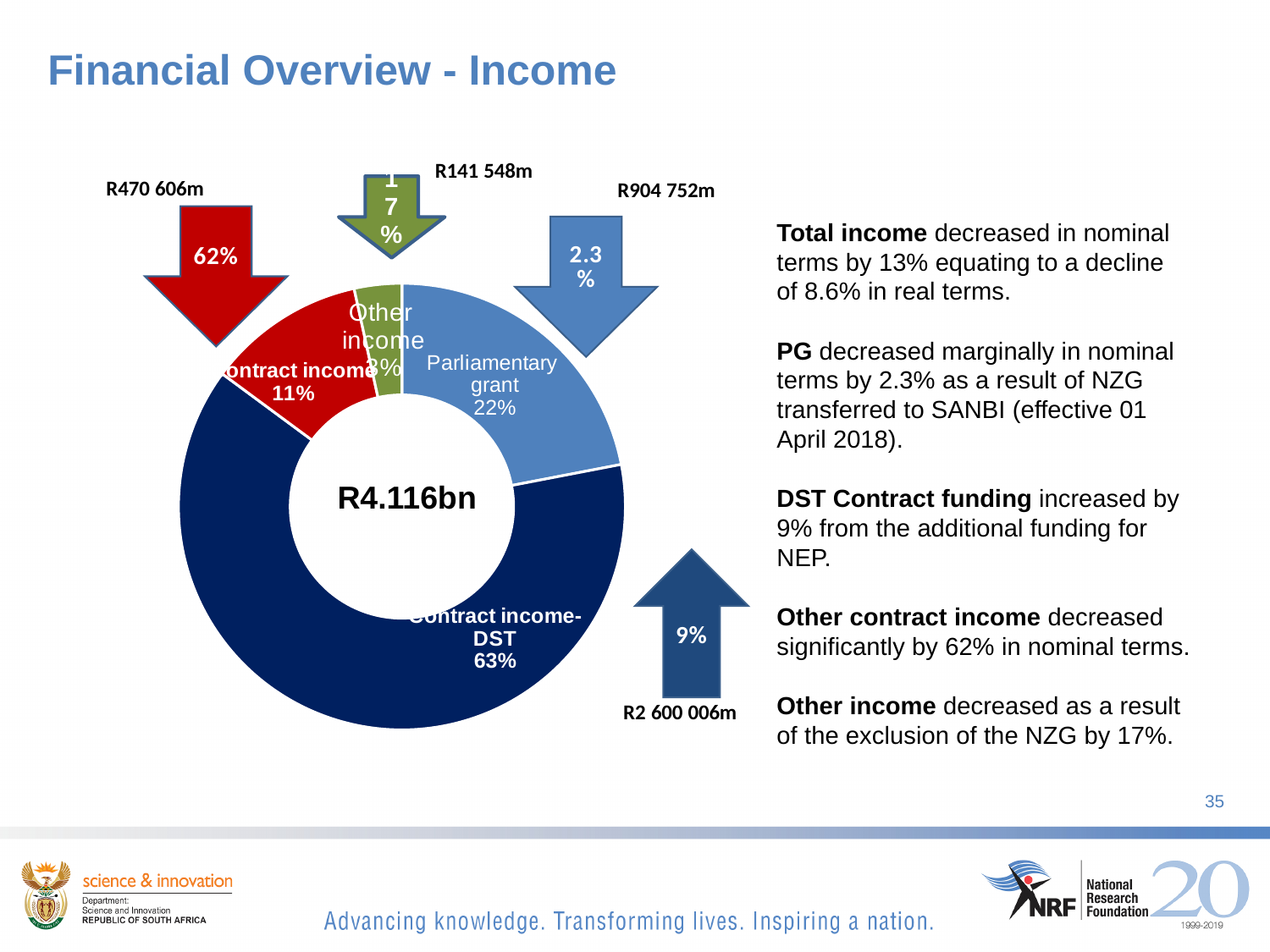
Which income category has the smallest share of the chart? Other income Which income category has the largest share of the chart? Contract income-DST What percentage of income does Other income represent? 3% What percentage of income does Contract income-DST represent? 63% How many percentage points larger is the Parliamentary grant than the red Contract income slice? 11 percentage points How many percentage points larger is Contract income-DST than the Parliamentary grant? 41 percentage points Which is larger: the Parliamentary grant share or the red Contract income share? Parliamentary grant What percentage of income does the Parliamentary grant represent? 22% What total value is shown in the centre of the doughnut chart? R4.116bn What percentage of income does the red Contract income slice represent? 11% How many income categories are shown in the chart? 4 What kind of chart is shown on the slide? Doughnut (pie) chart